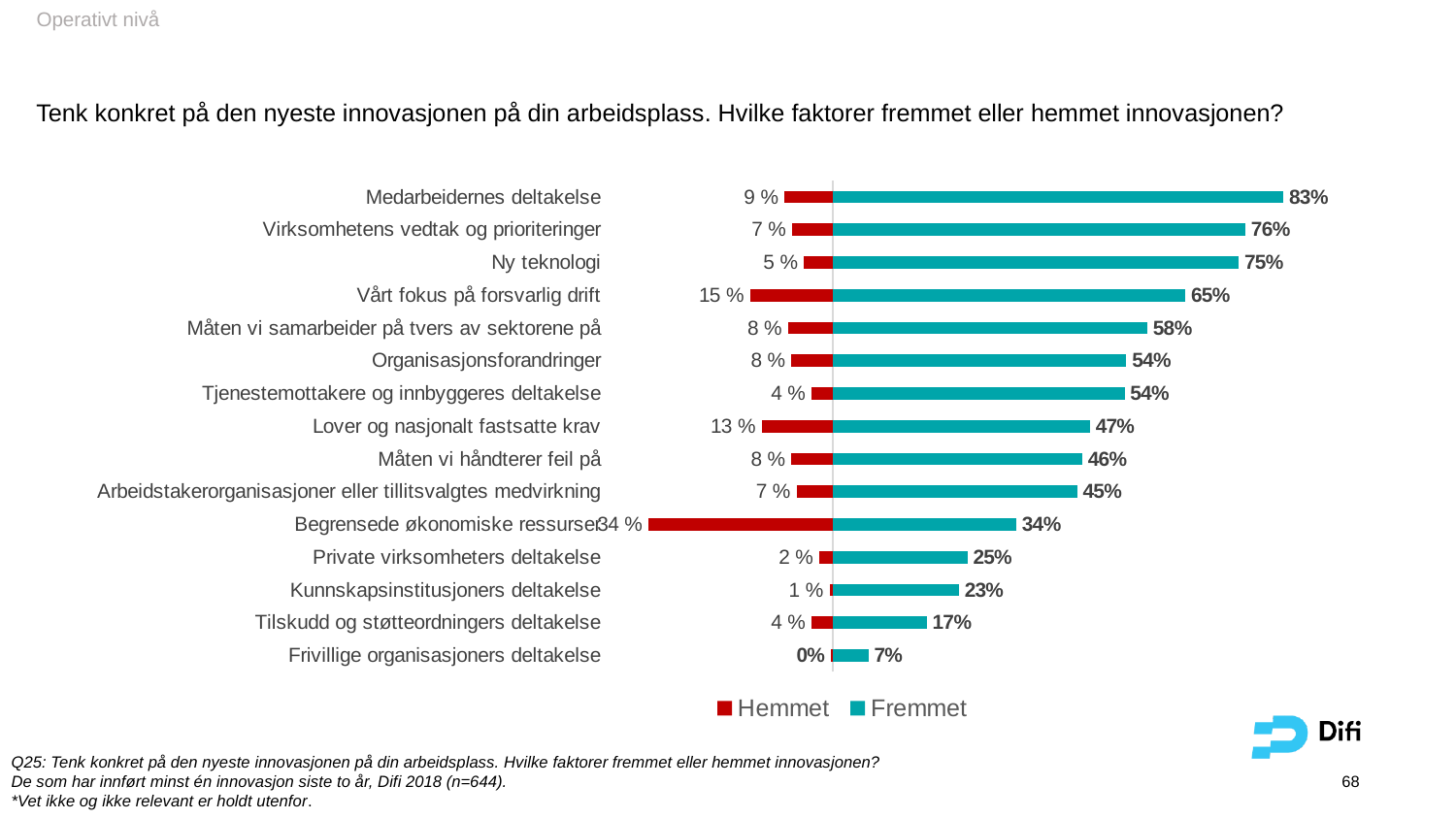
Which category has the highest Fremmet value? Medarbeidernes deltakelse Which category has the lowest Fremmet value? Frivillige organisasjoners deltakelse What is the Hemmet value for Lover og nasjonalt fastsatte krav? 13 % What is the Fremmet value for Medarbeidernes deltakelse? 83% What kind of chart is shown on the slide? Bar chart What is the Fremmet value for Ny teknologi? 75% What is the difference between the Fremmet values for Virksomhetens vedtak og prioriteringer and Vårt fokus på forsvarlig drift? 11 percentage points Which category has the highest Hemmet value? Begrensede økonomiske ressurser What is the Hemmet value for Begrensede økonomiske ressurser? 34 % Which is larger: the Fremmet value for Private virksomheters deltakelse or for Kunnskapsinstitusjoners deltakelse? Private virksomheters deltakelse How many categories are shown in the chart? 15 How many series does the legend list? 2